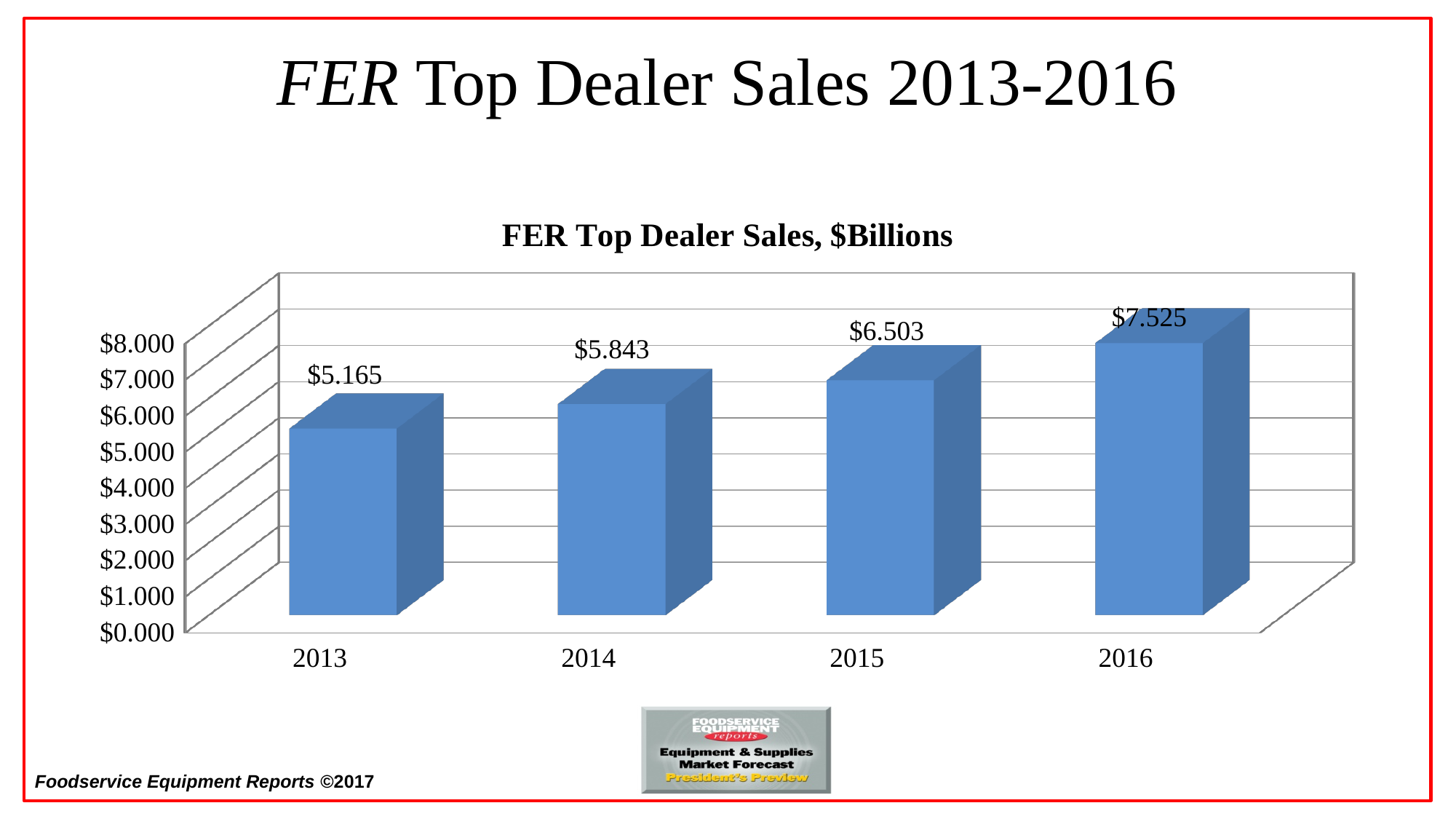
What is the value for 2013? $5.165 What is the value for 2015? $6.503 How many years are shown on the chart? 4 Do the values rise or fall from 2013 to 2016? rise What is the value for 2016? $7.525 What is the difference between the 2015 and 2014 values? $0.660 What is the value for 2014? $5.843 Which year has the lowest value? 2013 Which year has the highest value? 2016 What kind of chart is shown? bar chart Which is larger, the value for 2014 or the value for 2015? 2015 What is the difference between the 2016 and 2013 values? $2.360